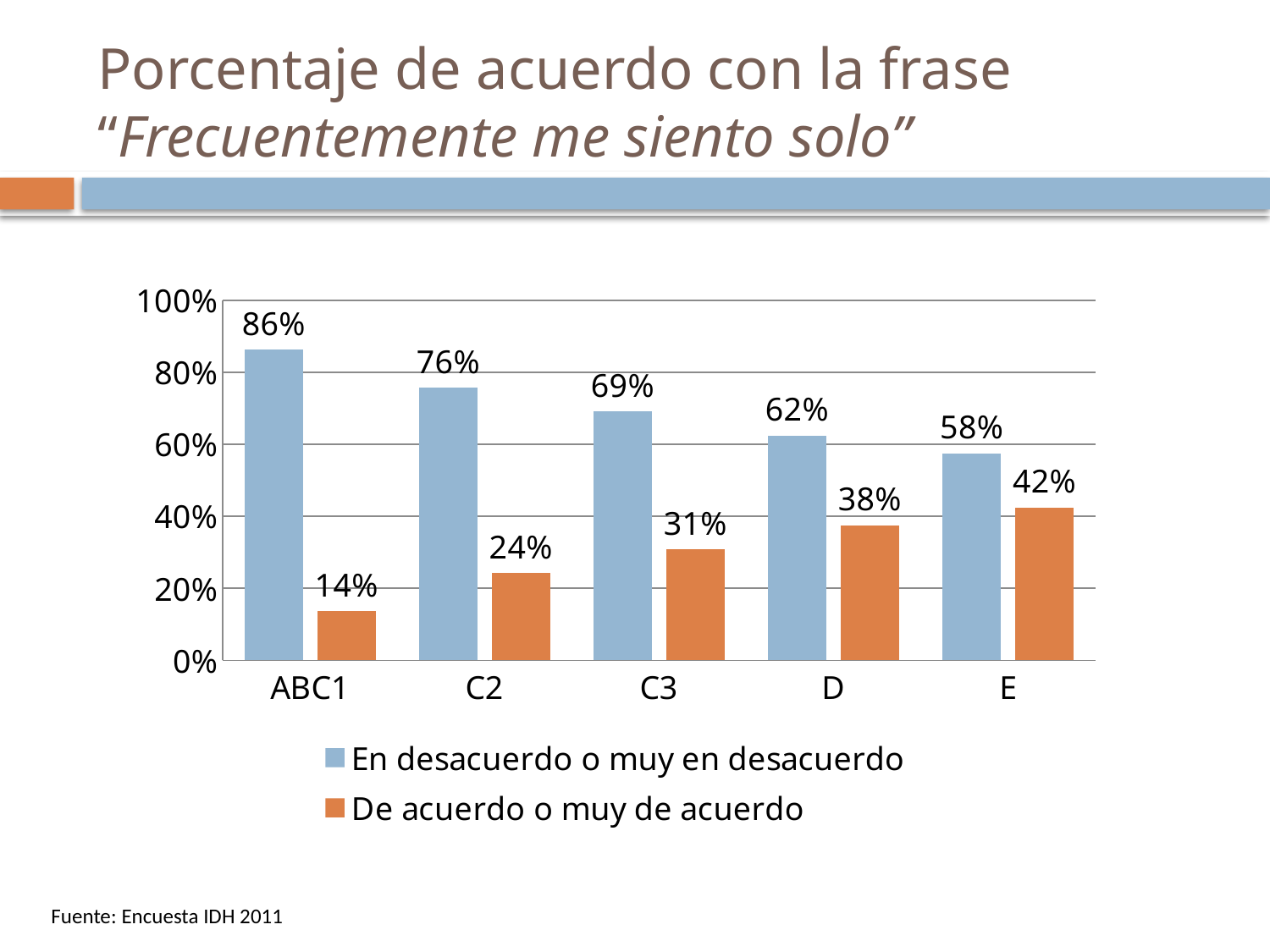
Which category has the lowest value for "En desacuerdo o muy en desacuerdo"? E Is the value for "En desacuerdo o muy en desacuerdo" for C2 greater or less than 60%? greater How many categories are shown on the x axis? 5 Which is larger: the "De acuerdo o muy de acuerdo" value for D or for C2? D What is the value for "De acuerdo o muy de acuerdo" for E? 42% Do the "De acuerdo o muy de acuerdo" values rise or fall from ABC1 to E? rise What is the value for "En desacuerdo o muy en desacuerdo" for ABC1? 86% How many series does the legend list? 2 What kind of chart is shown on the slide? bar chart What is the difference between the "En desacuerdo o muy en desacuerdo" values for ABC1 and E? 28% Which category has the highest value for "De acuerdo o muy de acuerdo"? E What is the value for "De acuerdo o muy de acuerdo" for C3? 31%